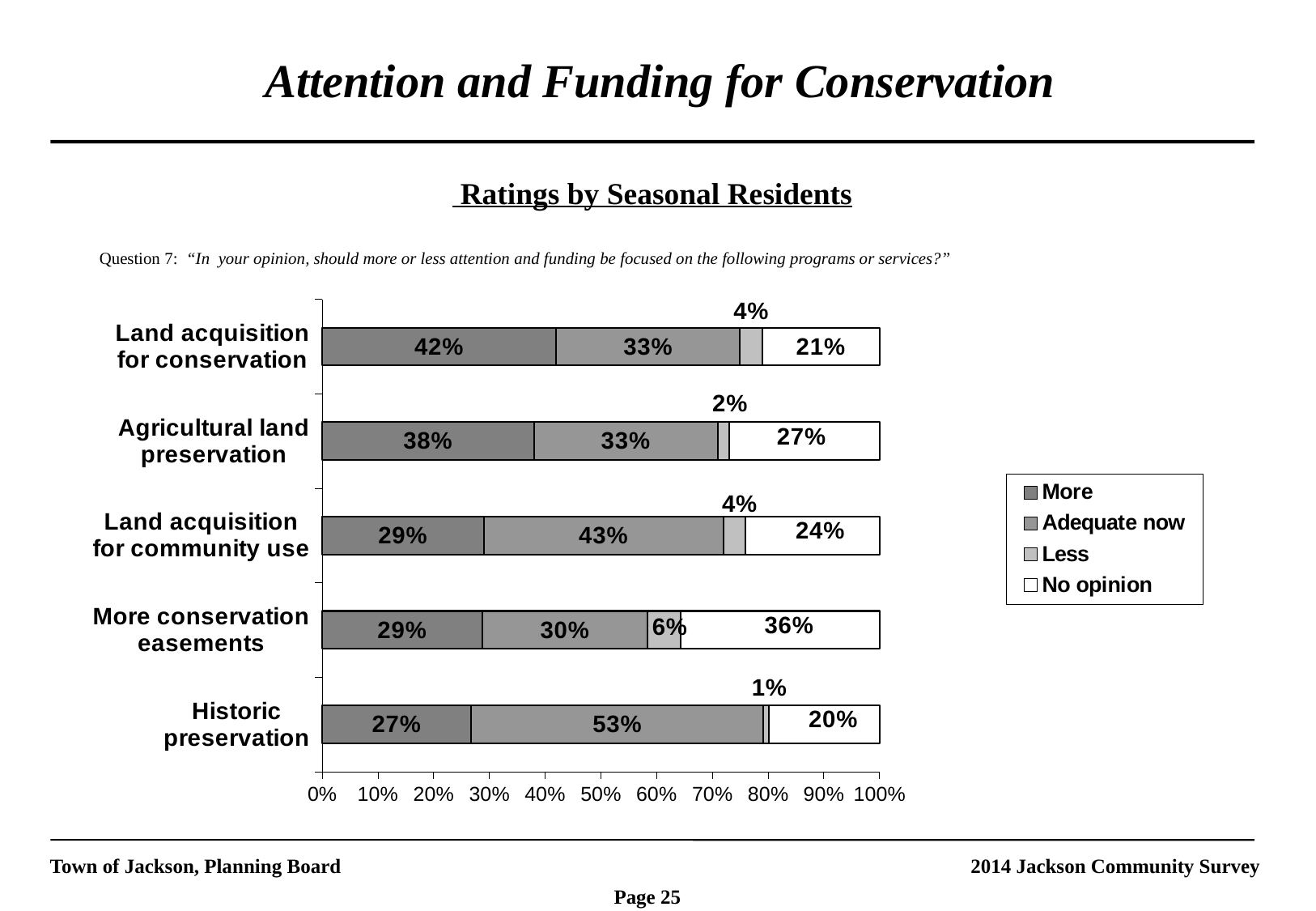
Which program has the lowest "Less" percentage? Historic preservation What percentage of seasonal residents said "More" for Land acquisition for conservation? 42% For Historic preservation, how much larger is the "Adequate now" value than the "More" value? 26 percentage points Which program has the highest "More" percentage? Land acquisition for conservation What are the four entries in the chart's legend? More, Adequate now, Less, No opinion How many programs or services are listed on the chart? 5 Which has a larger "No opinion" value: Agricultural land preservation or Land acquisition for community use? Agricultural land preservation What is the "No opinion" value for More conservation easements? 36% How many response categories does the legend list? 4 What type of chart is shown on the slide? Stacked bar chart What percentage of seasonal residents said "Adequate now" for Historic preservation? 53% What is the "Less" value for Agricultural land preservation? 2%